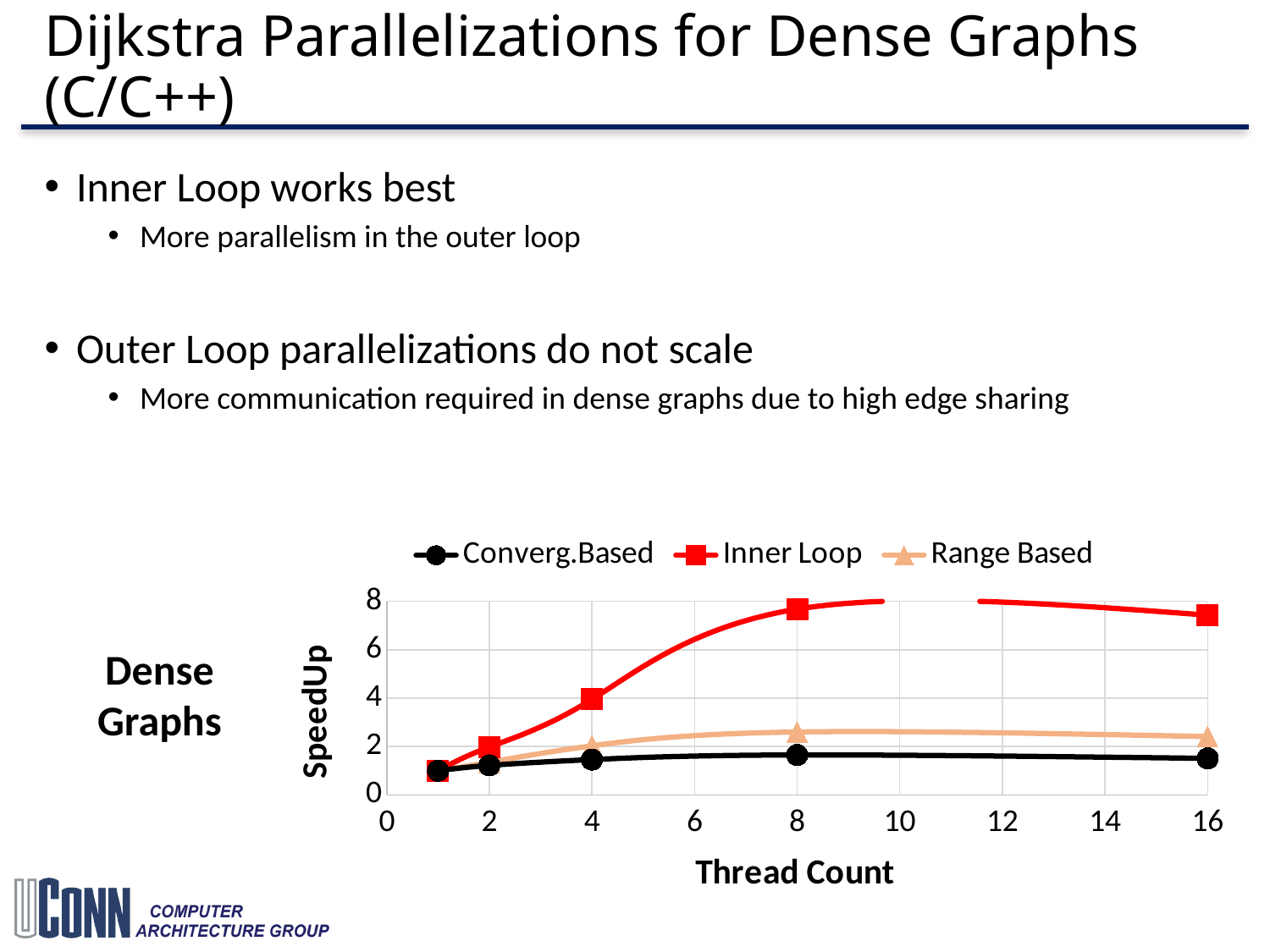
Is the SpeedUp for Converg.Based at 16 threads greater or less than 2? less What is the label of the chart's x axis? Thread Count Which series has the lowest SpeedUp at a thread count of 16? Converg.Based Which series has the highest SpeedUp at a thread count of 8? Inner Loop Is the SpeedUp for Inner Loop at 8 threads greater or less than 6? greater At 16 threads, which has the higher SpeedUp: Range Based or Converg.Based? Range Based What are the three series named in the chart's legend? Converg.Based, Inner Loop, Range Based Is the SpeedUp for Range Based at 8 threads greater or less than 4? less What kind of chart is shown on the slide? line chart Does the Inner Loop SpeedUp rise or fall as the thread count increases from 1 to 8? rise How many series does the chart's legend list? 3